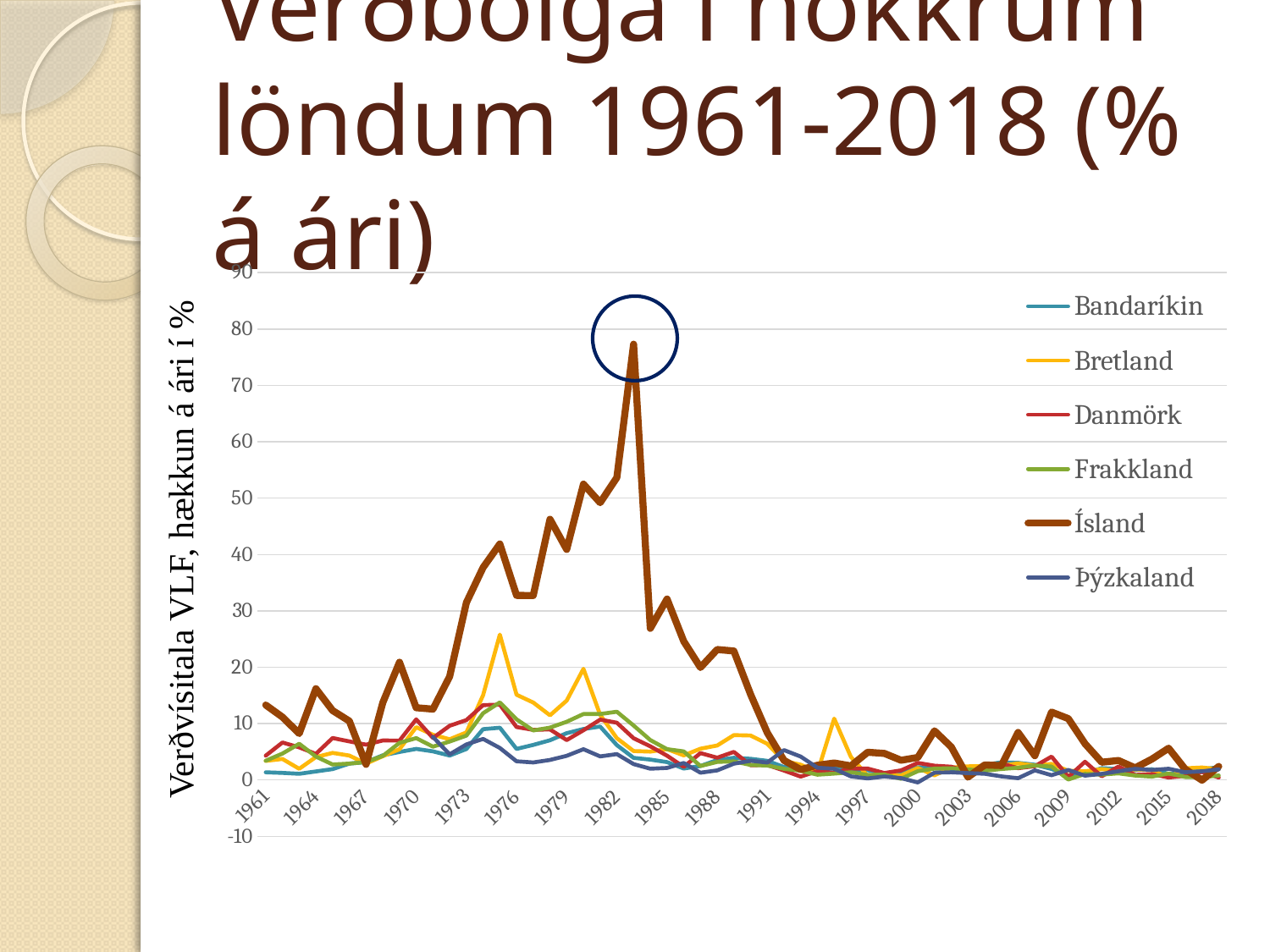
Which series is highlighted by the circle drawn on the chart? Ísland What kind of chart is shown on the slide? line chart What is the label of the vertical axis? Verðvísitala VLF, hækkun á ári í % Is the peak value for Ísland around 1983 greater or less than 70? greater Which country's series reaches the highest value on the chart? Ísland Is the value for Ísland in 1975 greater or less than 30? greater Is the value for Bretland in 1975 greater or less than 20? greater How many series does the legend list? 6 What is the last year shown on the x axis? 2018 What is the first year shown on the x axis? 1961 Does the Ísland series rise or fall between 1983 and 1991? fall Which is larger in 1975, the value for Ísland or the value for Bretland? Ísland